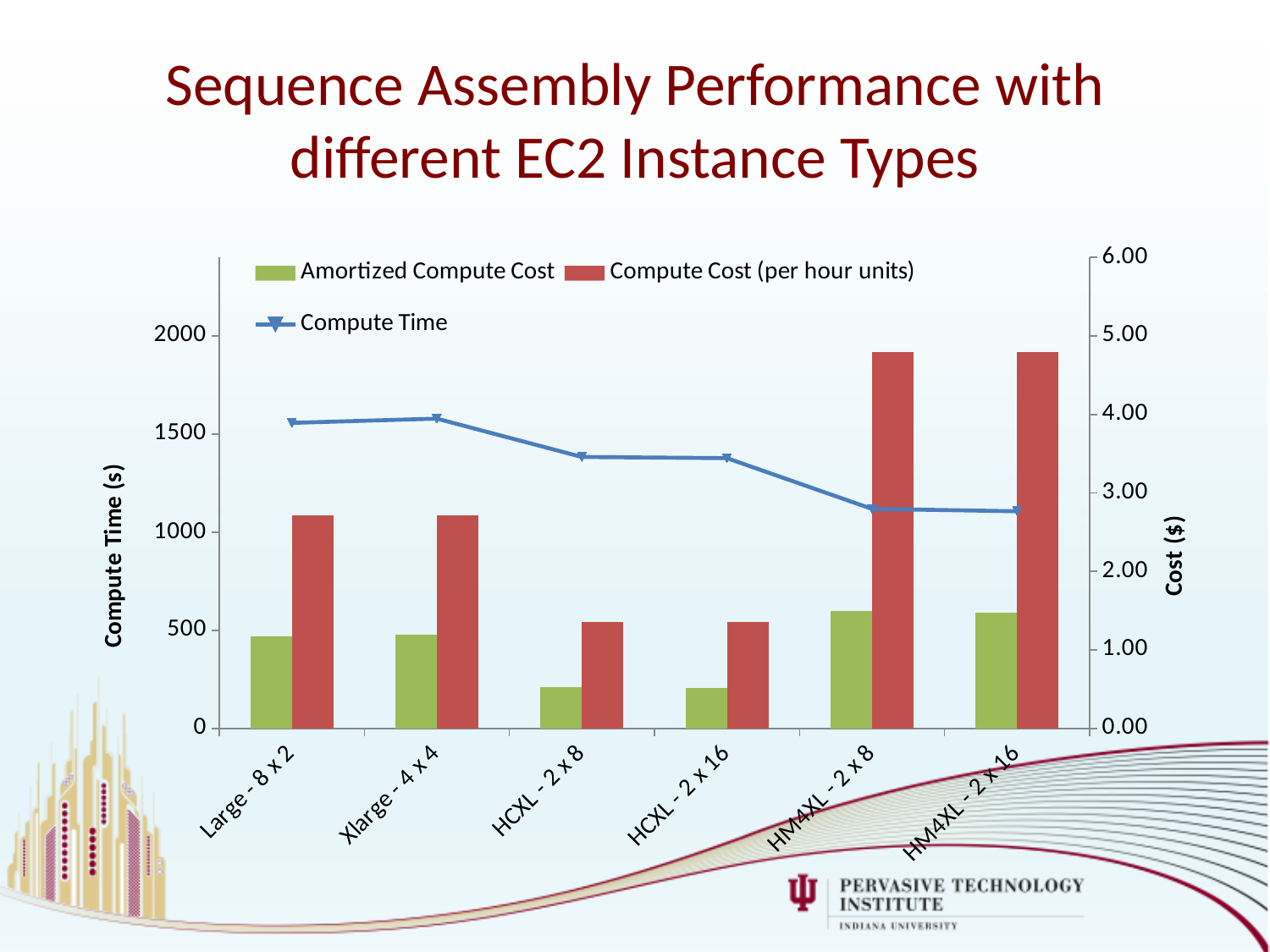
Does the Compute Time line generally rise or fall from Large - 8 x 2 to HM4XL - 2 x 16? fall Which has the larger Compute Cost (per hour units): Large - 8 x 2 or HCXL - 2 x 8? Large - 8 x 2 Is the Compute Cost (per hour units) value for HCXL - 2 x 8 greater or less than 2.00? less Is the Compute Cost (per hour units) value for HM4XL - 2 x 8 greater or less than 4.00? greater Is the Amortized Compute Cost value for HCXL - 2 x 16 greater or less than 1.00? less Which has the larger Compute Time: HCXL - 2 x 8 or HM4XL - 2 x 8? HCXL - 2 x 8 What is the title of the right-hand vertical axis? Cost ($) How many series does the legend list? 3 How many EC2 instance type categories are shown on the x axis? 6 What kind of chart is shown on the slide? A combined bar and line chart